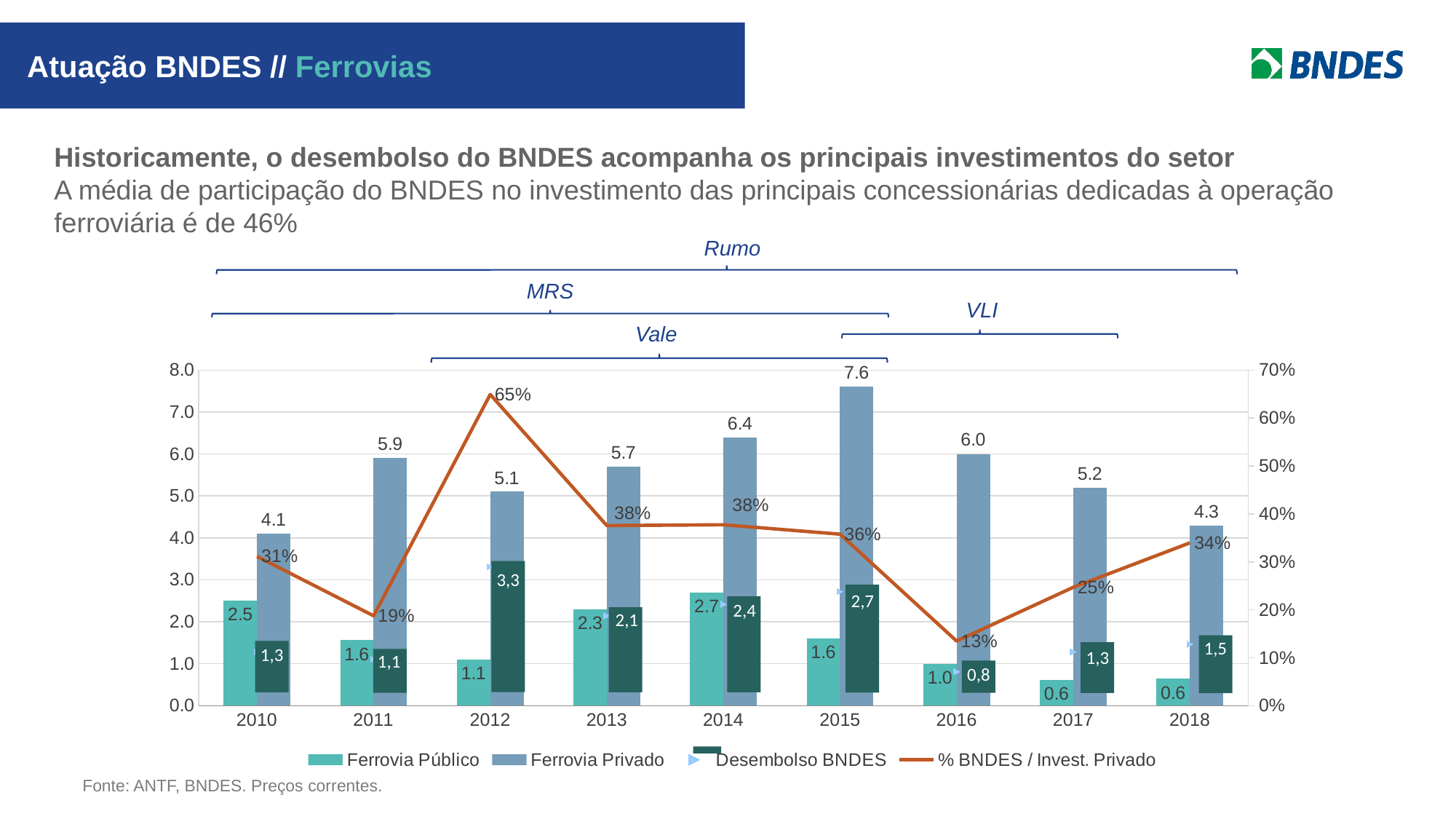
How many years are shown on the x axis? 9 What kind of chart is shown on the slide? Combined bar and line chart Does Ferrovia Público rise or fall from 2014 to 2018? Fall What is the difference between Ferrovia Privado in 2015 and in 2010? 3.5 How many series does the legend list? 4 In which year is Desembolso BNDES lowest? 2016 Which year has the larger Ferrovia Público value, 2014 or 2010? 2014 In which year is the % BNDES / Invest. Privado line lowest? 2016 In which year is Ferrovia Privado highest? 2015 What is the Desembolso BNDES value in 2012? 3,3 What is the % BNDES / Invest. Privado value in 2012? 65% What is the value of Ferrovia Privado in 2015? 7.6